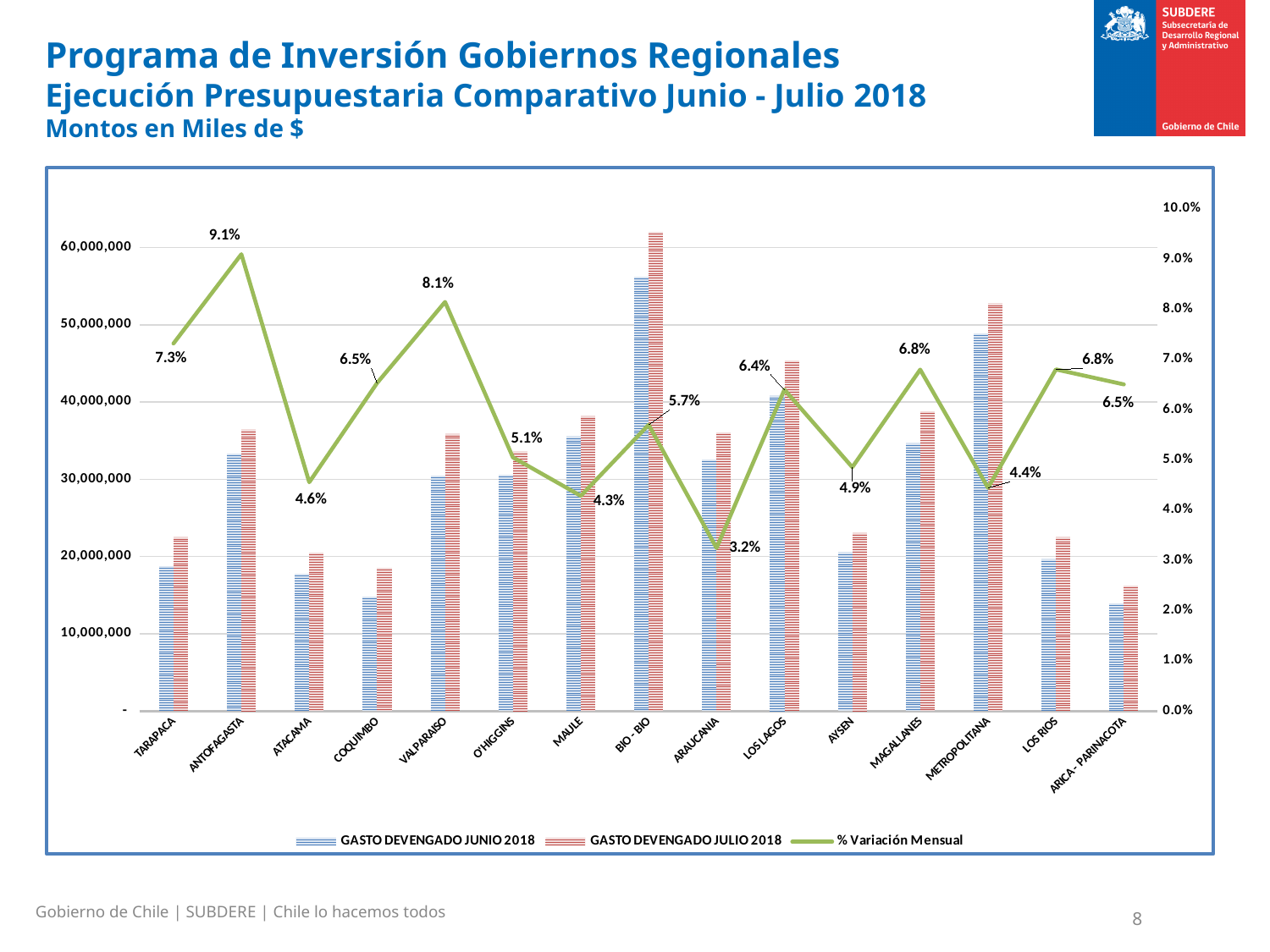
What kind of chart is shown on the slide? Combined bar and line chart What is the % Variación Mensual value for ANTOFAGASTA? 9.1% How many series does the chart legend list? 3 Which has a higher % Variación Mensual, TARAPACA or VALPARAISO? VALPARAISO What is the difference in percentage points between the % Variación Mensual of ANTOFAGASTA and ARAUCANIA? 5.9 percentage points What is the % Variación Mensual value for ARAUCANIA? 3.2% Which region has the lowest % Variación Mensual? ARAUCANIA How many regions are shown on the x axis of the chart? 15 Is the GASTO DEVENGADO JULIO 2018 value for BIO - BIO greater or less than 60,000,000? greater What is the % Variación Mensual value for VALPARAISO? 8.1% Which region has the highest % Variación Mensual? ANTOFAGASTA Is the GASTO DEVENGADO JUNIO 2018 value for COQUIMBO greater or less than 20,000,000? less